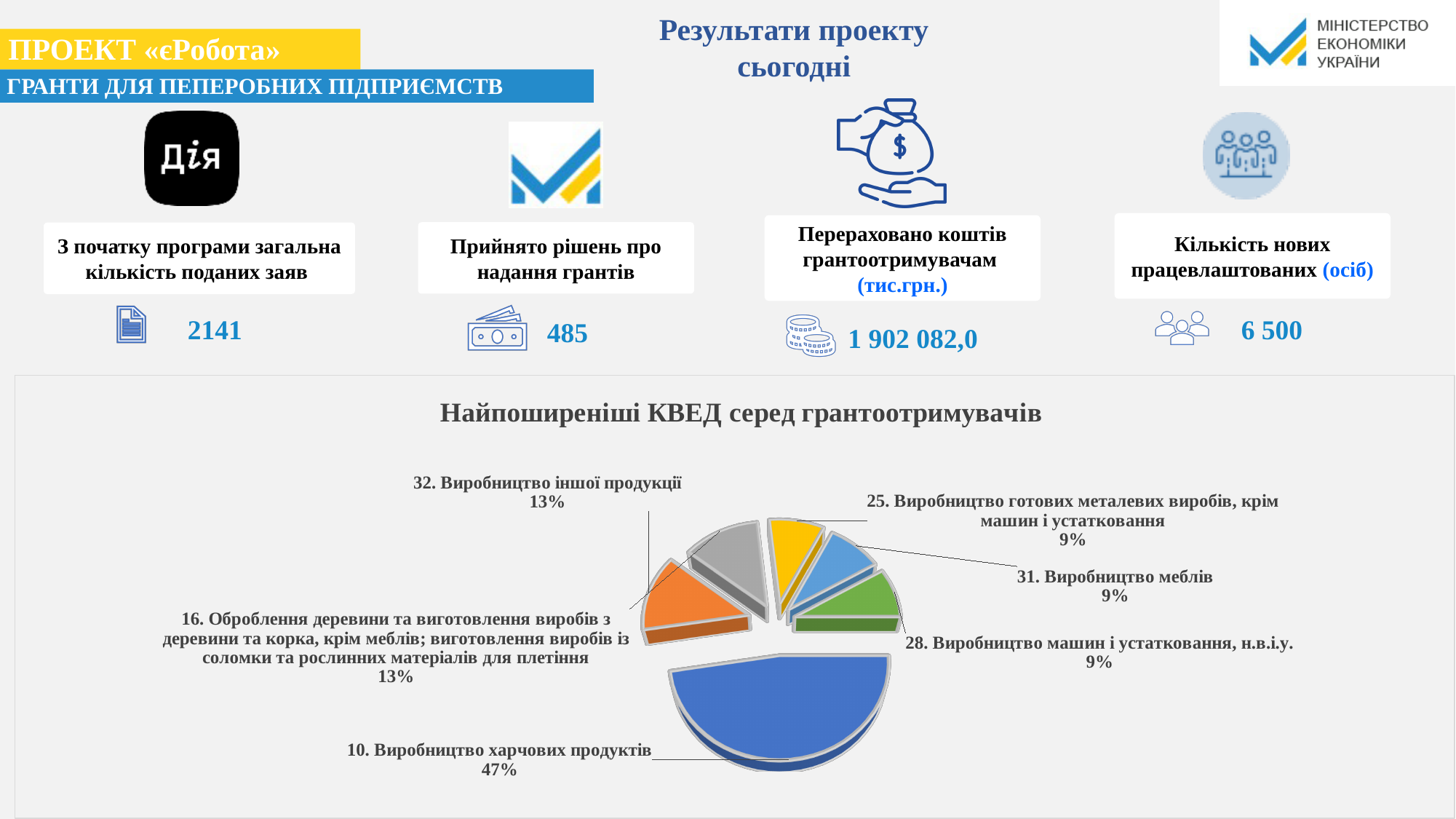
How many slices does the pie chart have? 6 What kind of chart is shown under the title "Найпоширеніші КВЕД серед грантоотримувачів"? pie chart What is the value shown for "28. Виробництво машин і устатковання, н.в.і.у."? 9% What is the value shown for "32. Виробництво іншої продукції"? 13% What share of the pie does "10. Виробництво харчових продуктів" have? 47% What is the difference between the share of "32. Виробництво іншої продукції" and "31. Виробництво меблів"? 4% What is the chart's title? Найпоширеніші КВЕД серед грантоотримувачів Which is larger: the share of "16. Оброблення деревини..." or "25. Виробництво готових металевих виробів..."? 16. Оброблення деревини... What is the value shown for "31. Виробництво меблів"? 9% What colour is the slice for "10. Виробництво харчових продуктів"? blue What is the difference between the share of "10. Виробництво харчових продуктів" and "32. Виробництво іншої продукції"? 34% Which category has the largest slice of the pie? 10. Виробництво харчових продуктів